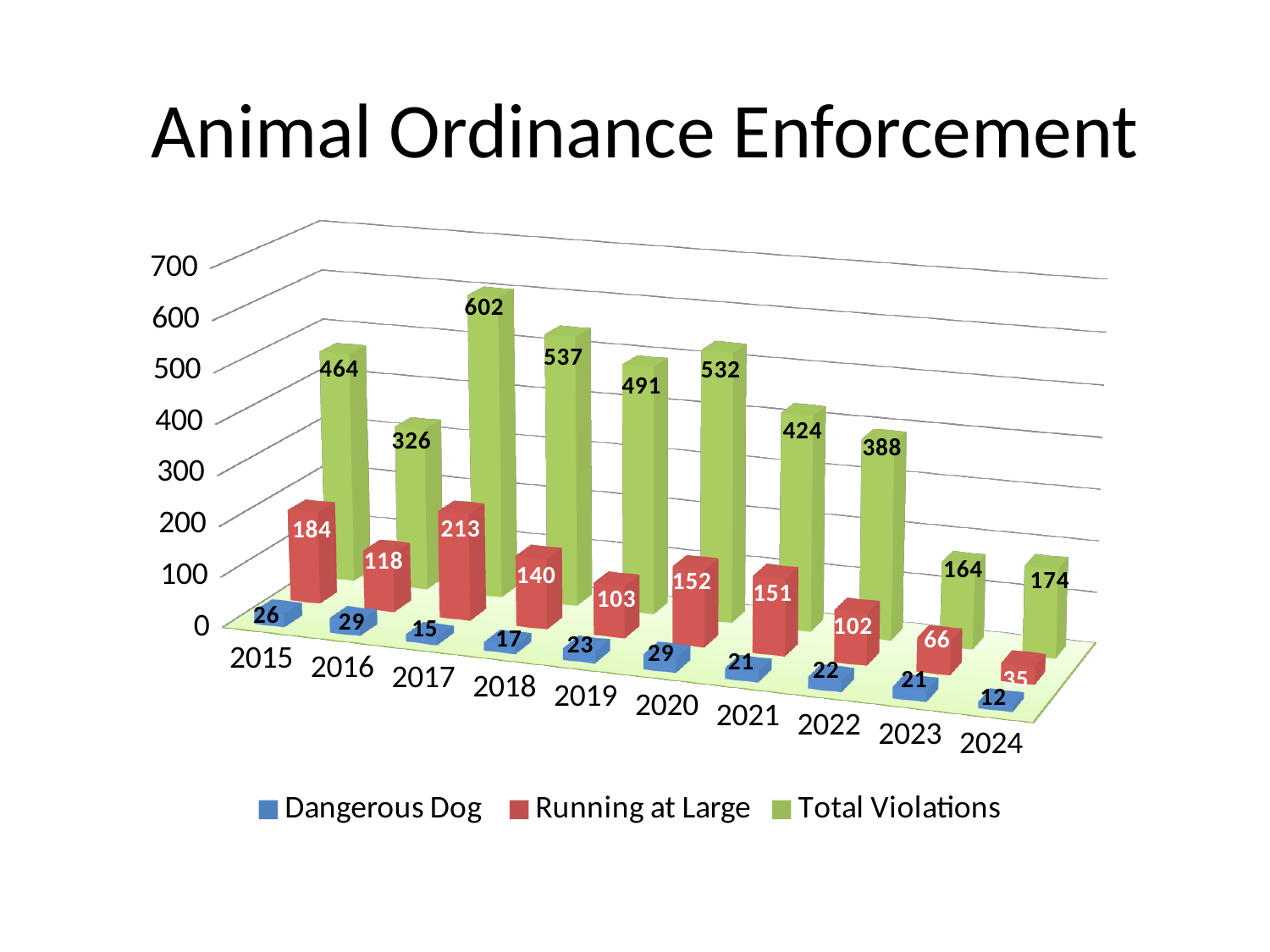
What is the value for Running at Large in 2017? 213 Do the Running at Large values rise or fall from 2021 to 2024? fall What kind of chart is shown? bar chart Which year has the highest Total Violations? 2017 Which is larger, Running at Large in 2015 or Running at Large in 2020? Running at Large in 2015 How many years are shown on the x axis? 10 What is the value for Total Violations in 2018? 537 What is the title of the chart? Animal Ordinance Enforcement What is the difference between Total Violations in 2018 and 2016? 211 How many series does the legend list? 3 What is the value for Dangerous Dog in 2024? 12 Which year has the lowest Total Violations? 2023